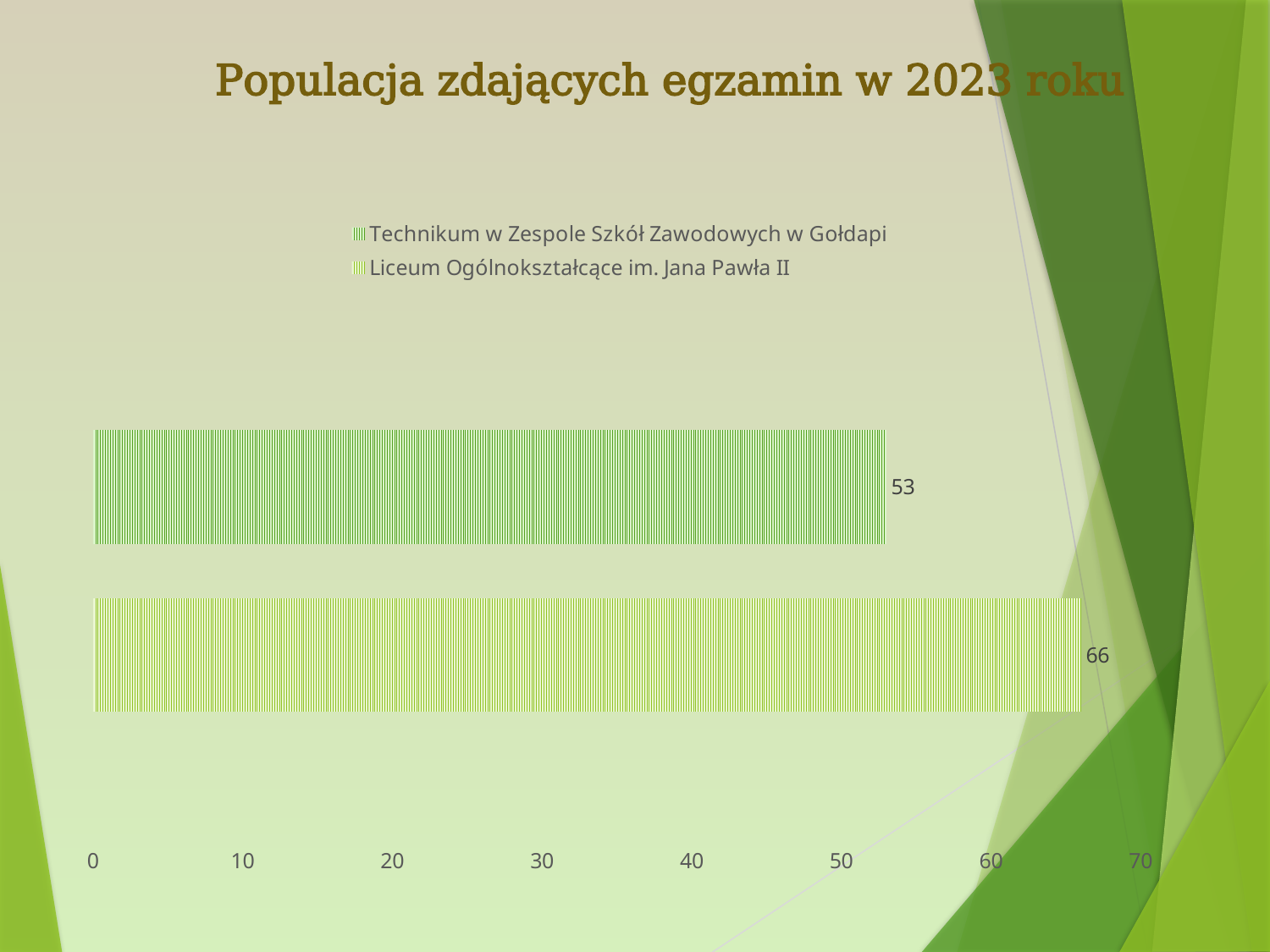
Which series has the highest value? Liceum Ogólnokształcące im. Jana Pawła II How many bars are plotted on the chart? 2 Is the value for Technikum w Zespole Szkół Zawodowych w Gołdapi greater or less than 60? less What is the value for Liceum Ogólnokształcące im. Jana Pawła II? 66 How many series does the legend list? 2 Which series has the lowest value? Technikum w Zespole Szkół Zawodowych w Gołdapi Which is larger, the value for Technikum w Zespole Szkół Zawodowych w Gołdapi or the value for Liceum Ogólnokształcące im. Jana Pawła II? Liceum Ogólnokształcące im. Jana Pawła II Is the value for Liceum Ogólnokształcące im. Jana Pawła II greater or less than 60? greater What is the difference between the values for Liceum Ogólnokształcące im. Jana Pawła II and Technikum w Zespole Szkół Zawodowych w Gołdapi? 13 What kind of chart is shown on the slide? bar chart What is the title of the slide? Populacja zdających egzamin w 2023 roku What is the value for Technikum w Zespole Szkół Zawodowych w Gołdapi? 53